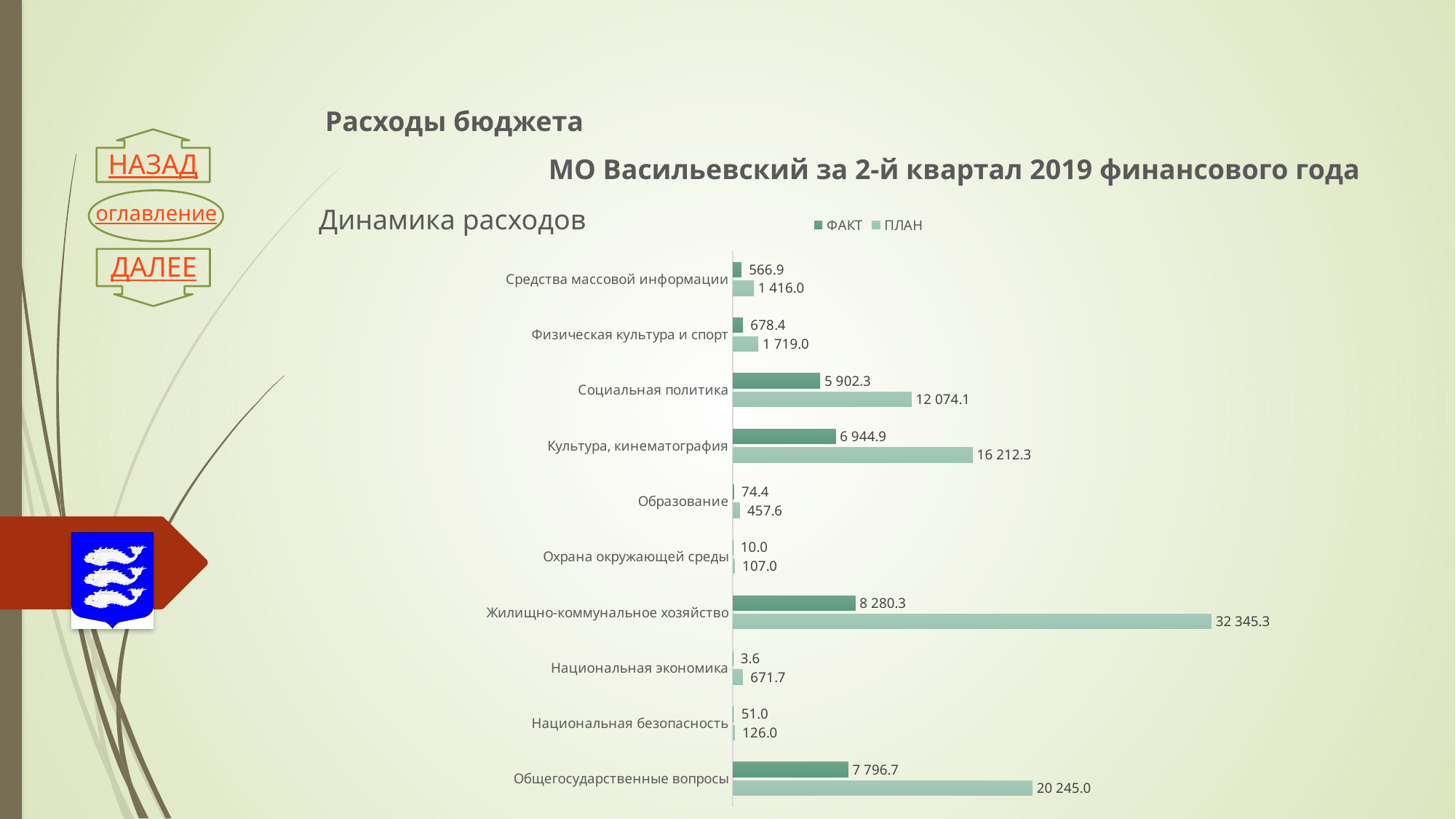
Which category has the lowest ФАКТ value? Национальная экономика What is the ФАКТ value for Жилищно-коммунальное хозяйство? 8 280.3 What is the ФАКТ value for Охрана окружающей среды? 10.0 Which category has the highest ПЛАН value? Жилищно-коммунальное хозяйство What is the ПЛАН value for Культура, кинематография? 16 212.3 What kind of chart is shown on the slide? Bar chart How many series does the legend list? 2 What is the ПЛАН value for Общегосударственные вопросы? 20 245.0 What is the difference between the ПЛАН and ФАКТ values for Социальная политика? 6 171.8 What is the difference between the ПЛАН and ФАКТ values for Жилищно-коммунальное хозяйство? 24 065.0 Which is larger, the ФАКТ value for Культура, кинематография or the ФАКТ value for Общегосударственные вопросы? Общегосударственные вопросы How many categories are shown in the chart? 10